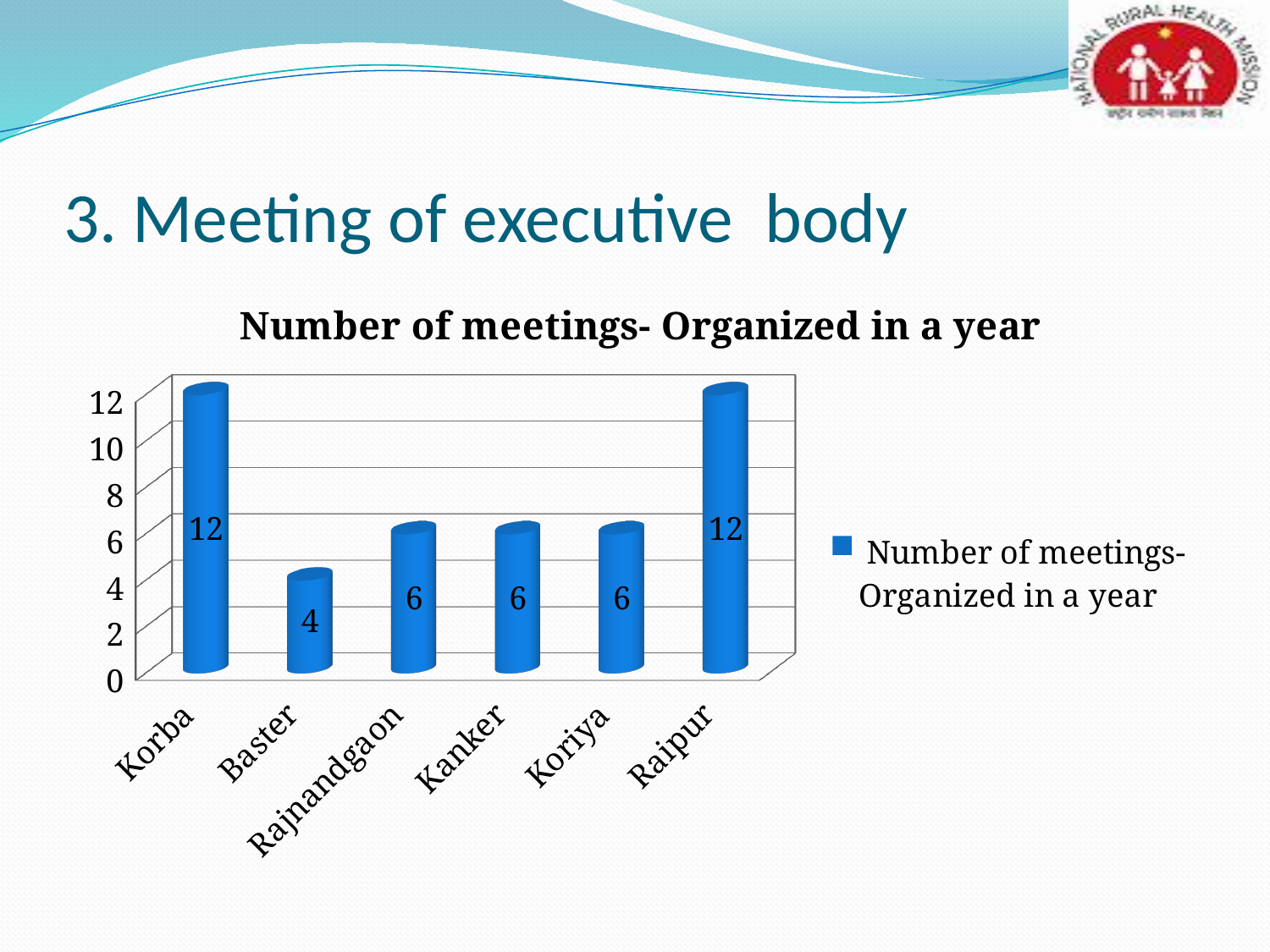
Which has more meetings organized in a year, Koriya or Raipur? Raipur How many districts are shown on the x axis of the chart? 6 What is the difference between the number of meetings for Korba and Baster? 8 What is the difference between the number of meetings for Raipur and Koriya? 6 Which has more meetings organized in a year, Kanker or Baster? Kanker What is the number of meetings organized in a year for Korba? 12 What is the number of meetings organized in a year for Raipur? 12 How many series does the chart legend list? 1 Which district has the lowest number of meetings organized in a year? Baster What is the number of meetings organized in a year for Rajnandgaon? 6 What is the number of meetings organized in a year for Baster? 4 What type of chart is shown on the slide? Bar chart